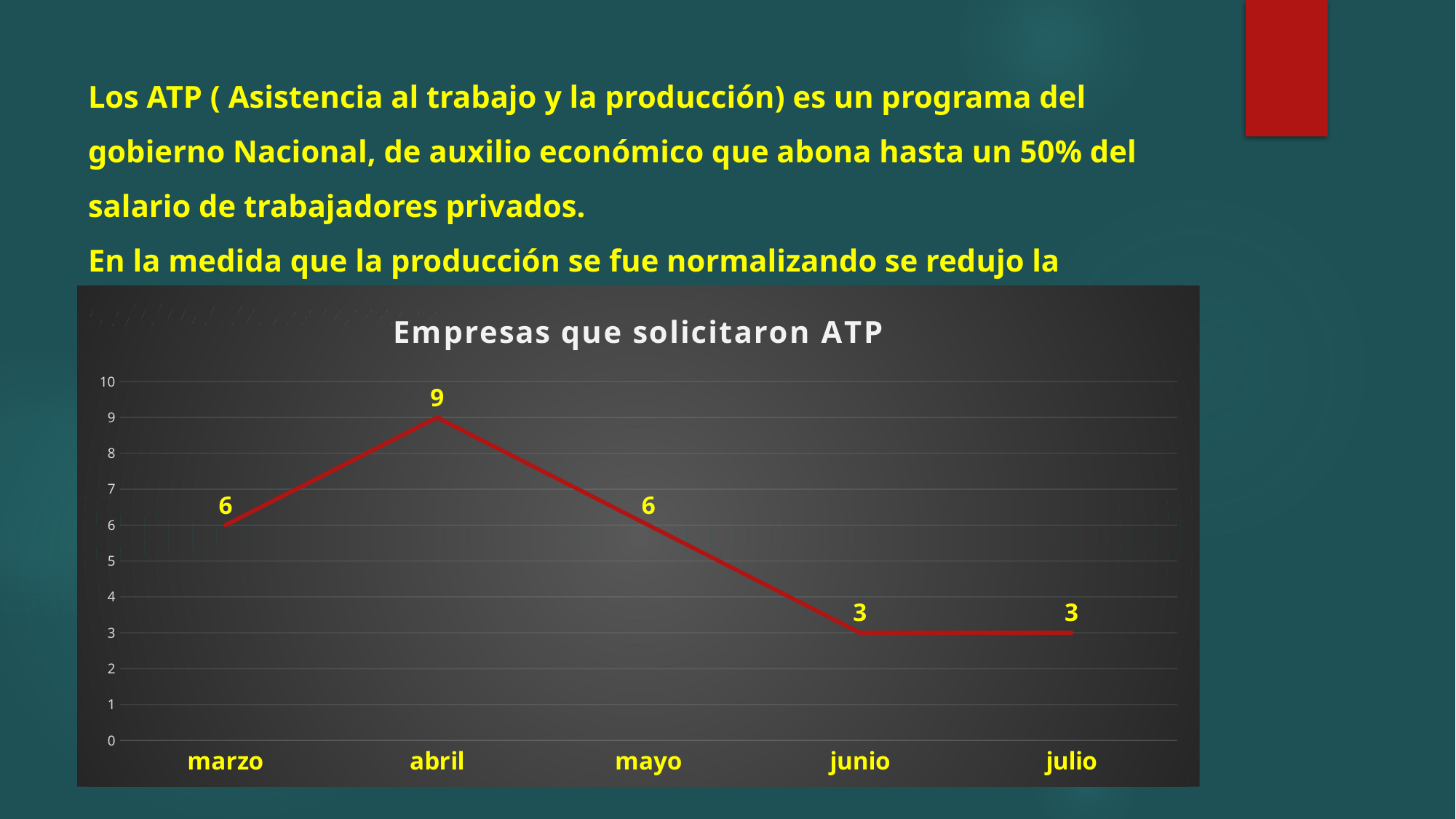
What is the value for abril in the chart 'Empresas que solicitaron ATP'? 9 What is the difference between the values for abril and mayo? 3 What is the value for junio in the chart? 3 What kind of chart is shown on the slide? line chart What is the title of the chart? Empresas que solicitaron ATP Do the values rise or fall from abril to junio? fall Is the value for abril greater or less than 8? greater Which month has the highest value in the chart? abril What is the difference between the values for marzo and julio? 3 Which is larger, the value for abril or the value for junio? abril What is the value for marzo in the chart? 6 How many months are plotted on the x axis of the chart? 5